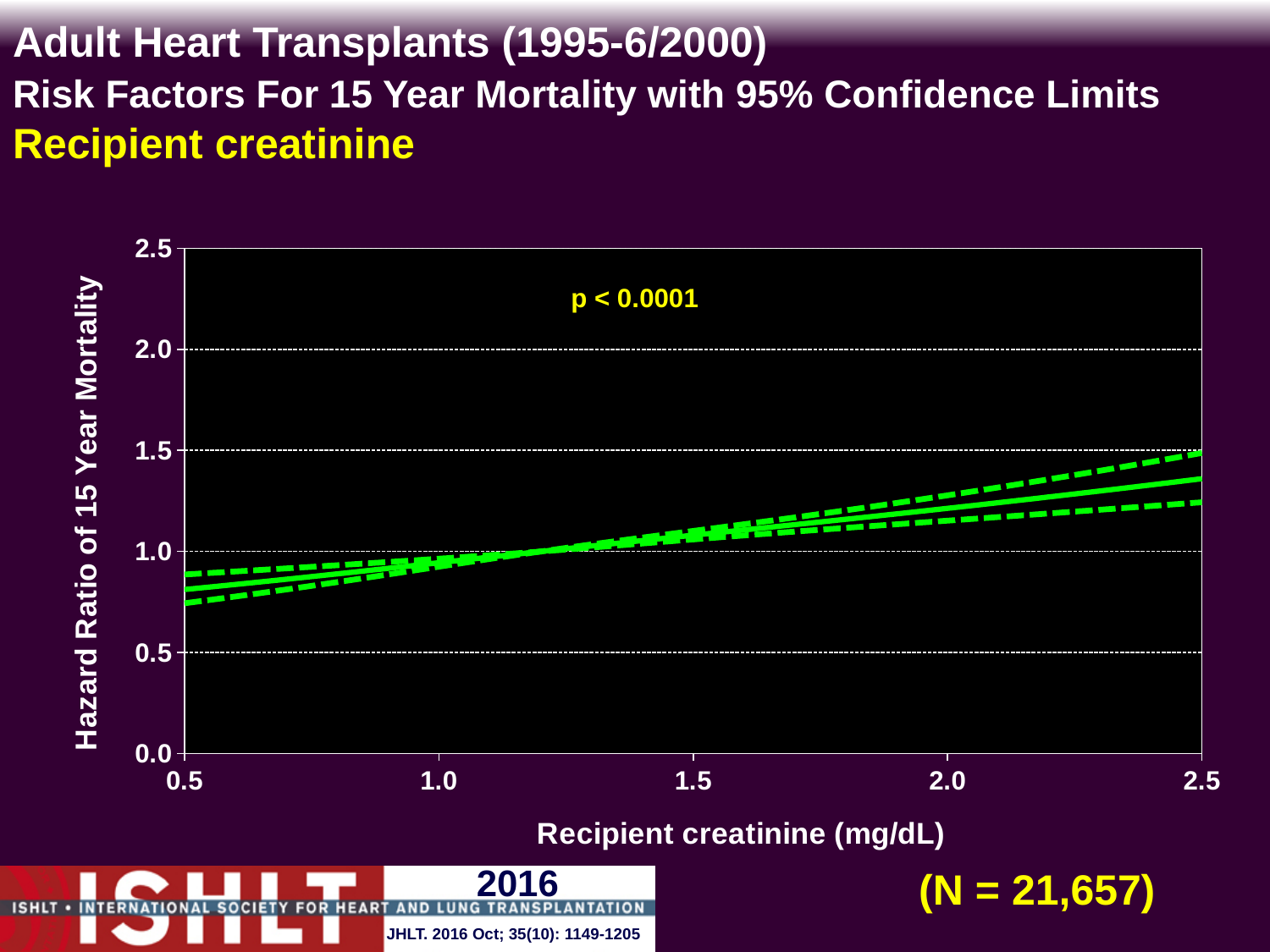
Is the hazard ratio at a recipient creatinine of 0.5 mg/dL greater or less than 0.5? greater Is the hazard ratio at a recipient creatinine of 2.0 mg/dL greater or less than 1.0? greater What p-value is printed on the chart? p < 0.0001 What sample size (N) is shown on the slide? N = 21,657 Does the hazard ratio of 15 year mortality rise or fall as recipient creatinine increases? rise Is the hazard ratio at a recipient creatinine of 0.5 mg/dL greater or less than 1.0? less At which recipient creatinine value shown on the x axis is the hazard ratio highest? 2.5 What kind of chart is shown on the slide? line chart At which recipient creatinine value shown on the x axis is the hazard ratio lowest? 0.5 Is the hazard ratio larger at a recipient creatinine of 2.0 mg/dL or 1.0 mg/dL? 2.0 mg/dL